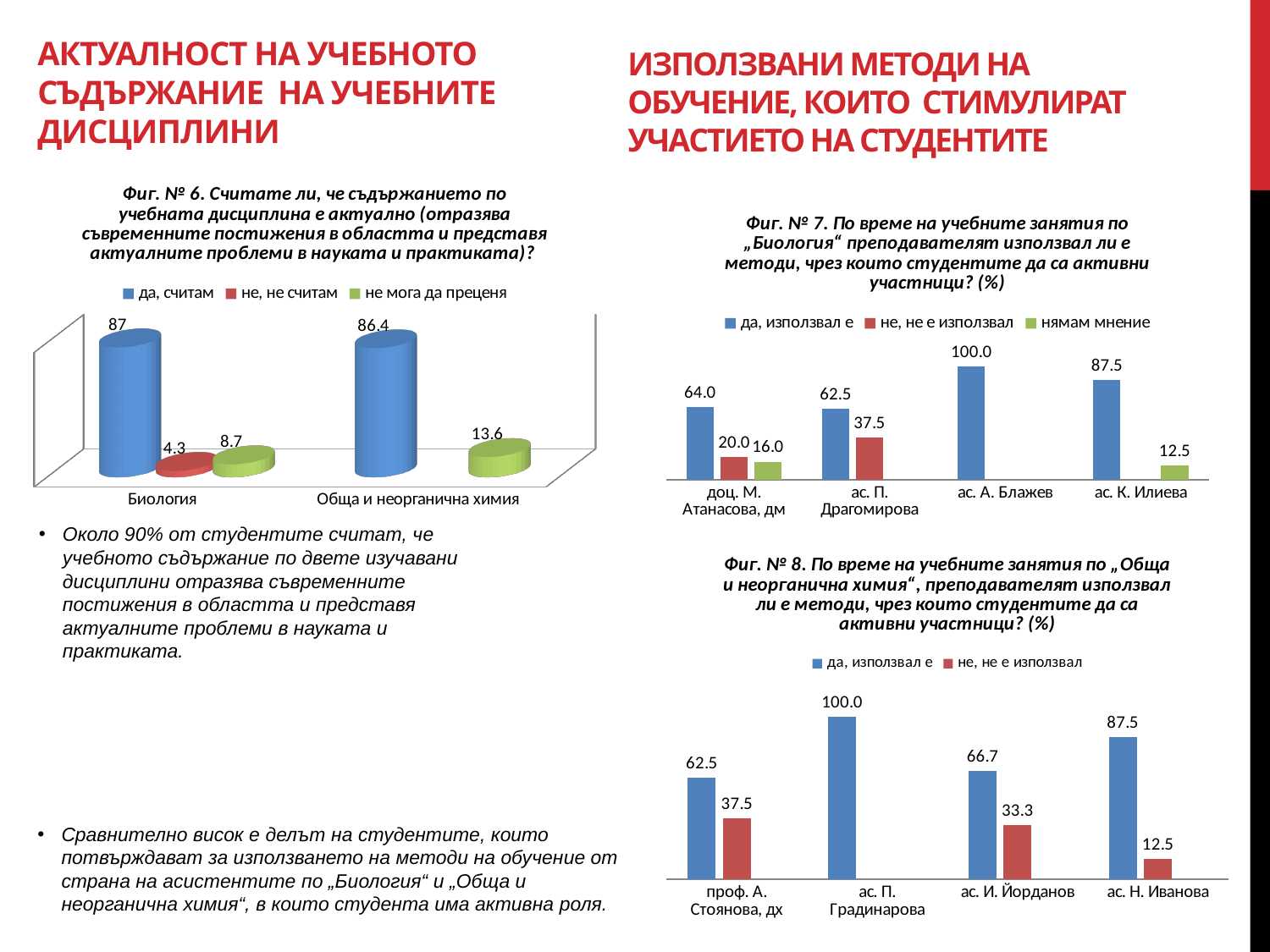
In the chart for Фиг. № 6, what is the value of "не мога да преценя" for Обща и неорганична химия? 13.6 In the chart for Фиг. № 8, which lecturer has the highest value for "да, използвал е"? ас. П. Градинарова In the chart for Фиг. № 6, what is the value of "да, считам" for Биология? 87 In the chart for Фиг. № 7, which lecturer has the lowest value for "да, използвал е"? ас. П. Драгомирова In the chart for Фиг. № 7, what is the value of "да, използвал е" for ас. А. Блажев? 100.0 In the chart for Фиг. № 8, what is the difference between "да, използвал е" and "не, не е използвал" for ас. Н. Иванова? 75.0 In the chart for Фиг. № 6, what is the difference between the "да, считам" values for Биология and Обща и неорганична химия? 0.6 In the chart for Фиг. № 8, what is the value of "не, не е използвал" for ас. И. Йорданов? 33.3 What kind of chart is Фиг. № 8? bar chart In the chart for Фиг. № 7, what is the value of "нямам мнение" for доц. М. Атанасова, дм? 16.0 In the chart for Фиг. № 7, how many lecturers are shown on the x axis? 4 In the chart for Фиг. № 6, how many series does the legend list? 3